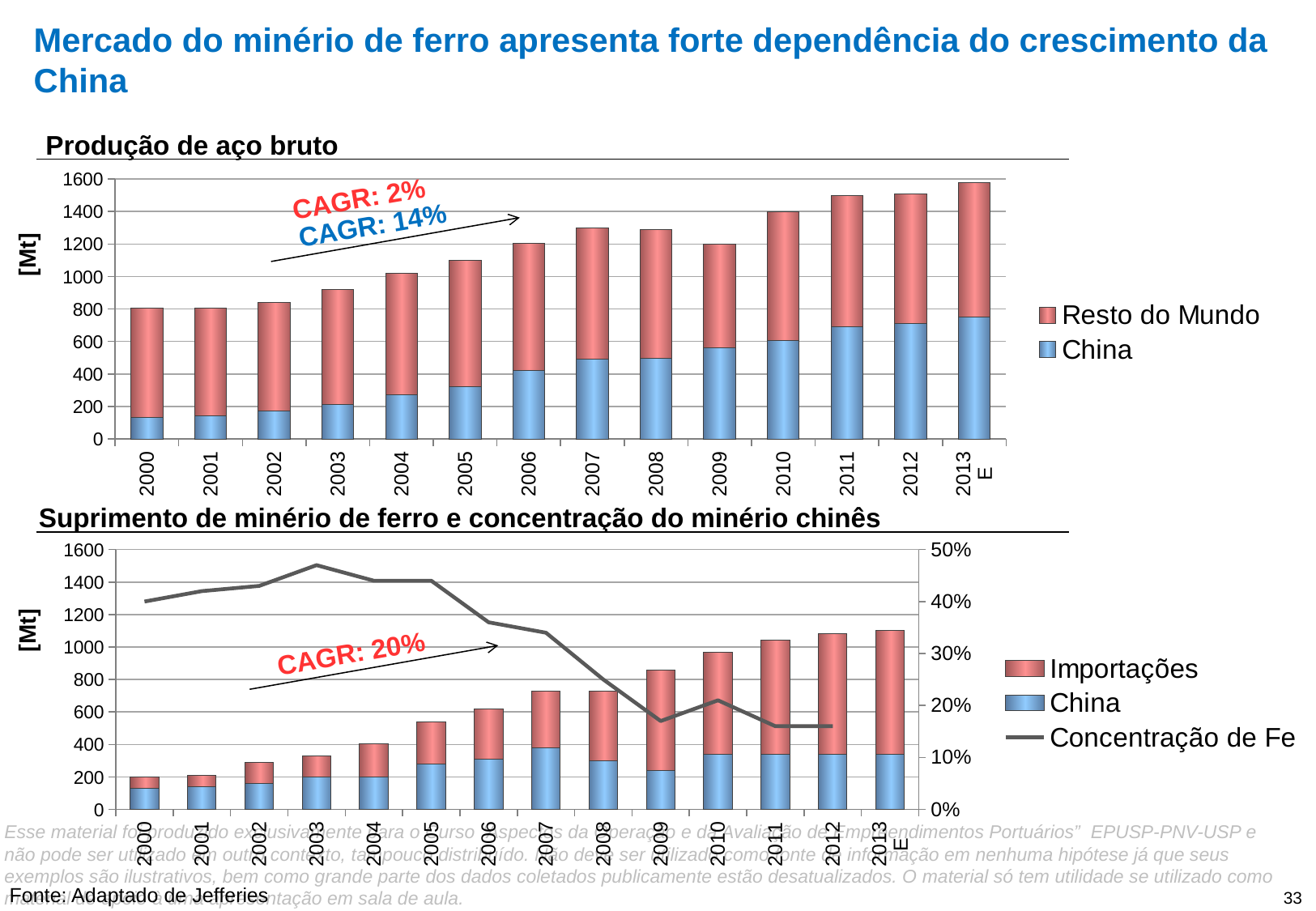
What type of chart is 'Produção de aço bruto'? stacked bar chart In the 'Suprimento de minério de ferro e concentração do minério chinês' chart, is the total bar for 2013E greater or less than 1000? greater In the 'Produção de aço bruto' chart, which year has the highest total production? 2013E In the 'Suprimento de minério de ferro e concentração do minério chinês' chart, how many series does the legend list? 3 In the 'Produção de aço bruto' chart, is the total bar for 2000 greater or less than 1000? less In the 'Suprimento de minério de ferro e concentração do minério chinês' chart, is the Concentração de Fe for 2012 greater or less than 20%? less In the 'Produção de aço bruto' chart, does the China series rise or fall from 2000 to 2013E? rise In the 'Produção de aço bruto' chart, how many series does the legend list? 2 In the 'Suprimento de minério de ferro e concentração do minério chinês' chart, does the Concentração de Fe line rise or fall from 2003 to 2012? fall In the 'Suprimento de minério de ferro e concentração do minério chinês' chart, which year has the highest Concentração de Fe? 2003 In the 'Produção de aço bruto' chart, how many years are shown on the x axis? 14